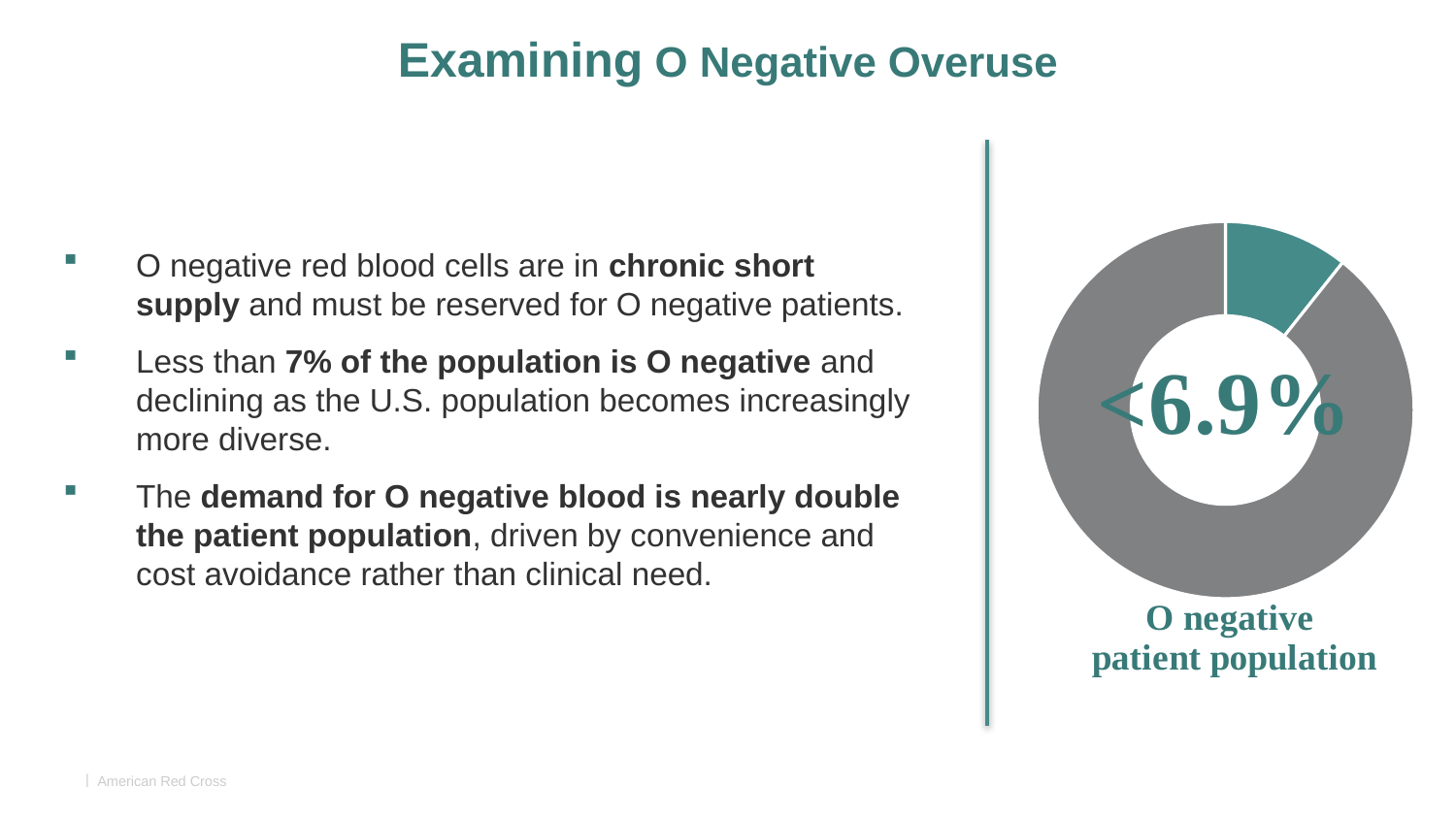
Which slice of the donut chart is the smallest? The teal slice What share of the donut chart does the teal slice represent, according to the label in the center? <6.9% What caption appears below the donut chart? O negative patient population How many slices does the donut chart have? 2 What colour is the small slice of the donut chart? Teal Which slice of the donut chart is larger, the teal slice or the gray slice? The gray slice What kind of chart is shown on the right side of the slide? Pie chart (donut) What value is printed in the center of the donut chart? <6.9%